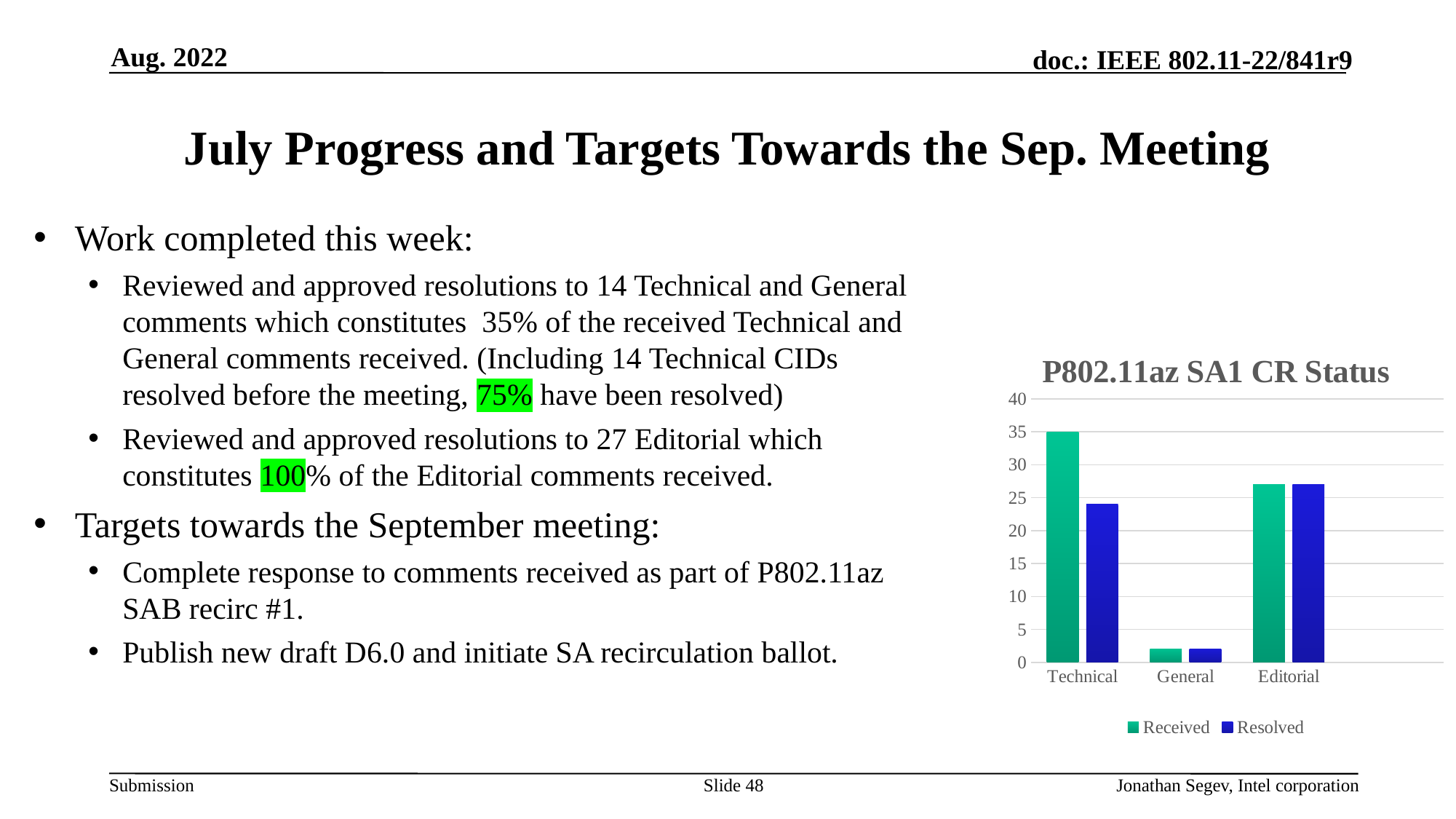
Which category has the highest Received value? Technical How many categories are shown on the x axis of the chart? 3 Which series is shown in blue in the chart legend? Resolved What is the title of the chart? P802.11az SA1 CR Status Which category has the lowest Received value? General Is the Received value for General greater or less than 5? less For the Technical category, which is larger: Received or Resolved? Received Is the Resolved value for Editorial greater or less than 25? greater Is the Received value for Technical greater or less than 30? greater What kind of chart is shown on the slide? bar chart How many series does the chart legend list? 2